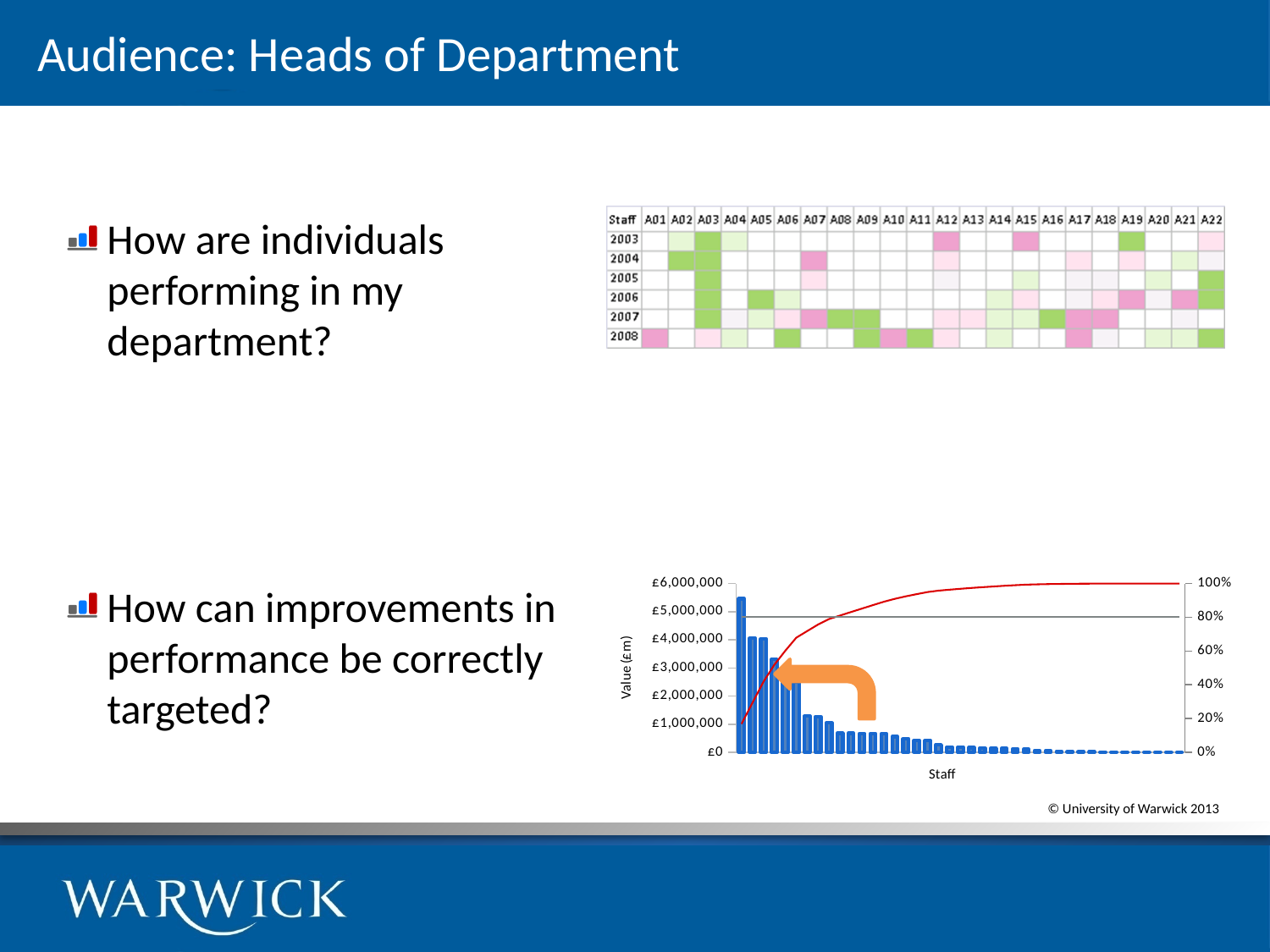
In the bottom-right chart, what is the label on the left vertical axis? Value (£m) In the bottom-right chart, is the first bar larger or smaller than the second bar? larger In the top-right heatmap table, how many year rows are shown? 6 In the bottom-right chart, what is the label on the x axis? Staff In the bottom-right chart, which bar is the highest? The first (leftmost) bar In the top-right heatmap table, how many staff columns (A01 to A22) are there? 22 In the bottom-right chart, is the value of the tallest (first) bar greater or less than £5,000,000? greater In the bottom-right chart, do the bar values rise or fall moving from left to right along the x axis? fall What kind of chart is shown at the bottom right of the slide? A bar chart with a cumulative line In the bottom-right chart, is the value of the second bar greater or less than £5,000,000? less In the bottom-right chart, what is the maximum value shown on the right vertical axis? 100%